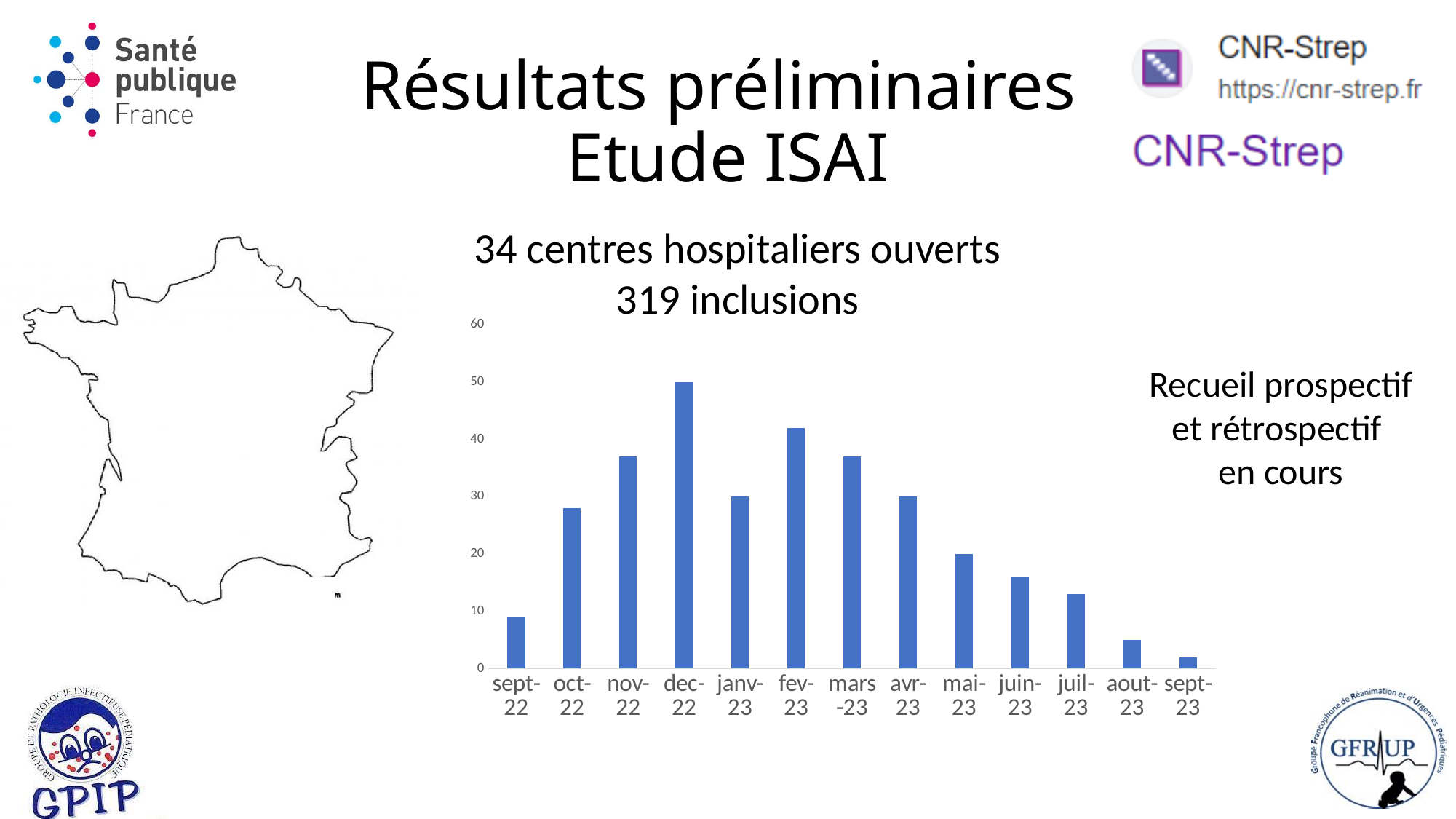
What is the highest value shown on the chart's vertical axis? 60 Which month has the highest bar in the chart? dec-22 Is the value for aout-23 greater or less than 10? less Which is larger, the value for oct-22 or the value for juin-23? oct-22 What kind of chart is shown on the slide? bar chart Is the value for sept-22 greater or less than 20? less Which is larger, the value for dec-22 or the value for fev-23? dec-22 Which month has the lowest bar in the chart? sept-23 From dec-22 to sept-23, do the values generally rise or fall? fall Is the value for dec-22 greater or less than 40? greater How many months are shown on the x axis of the chart? 13